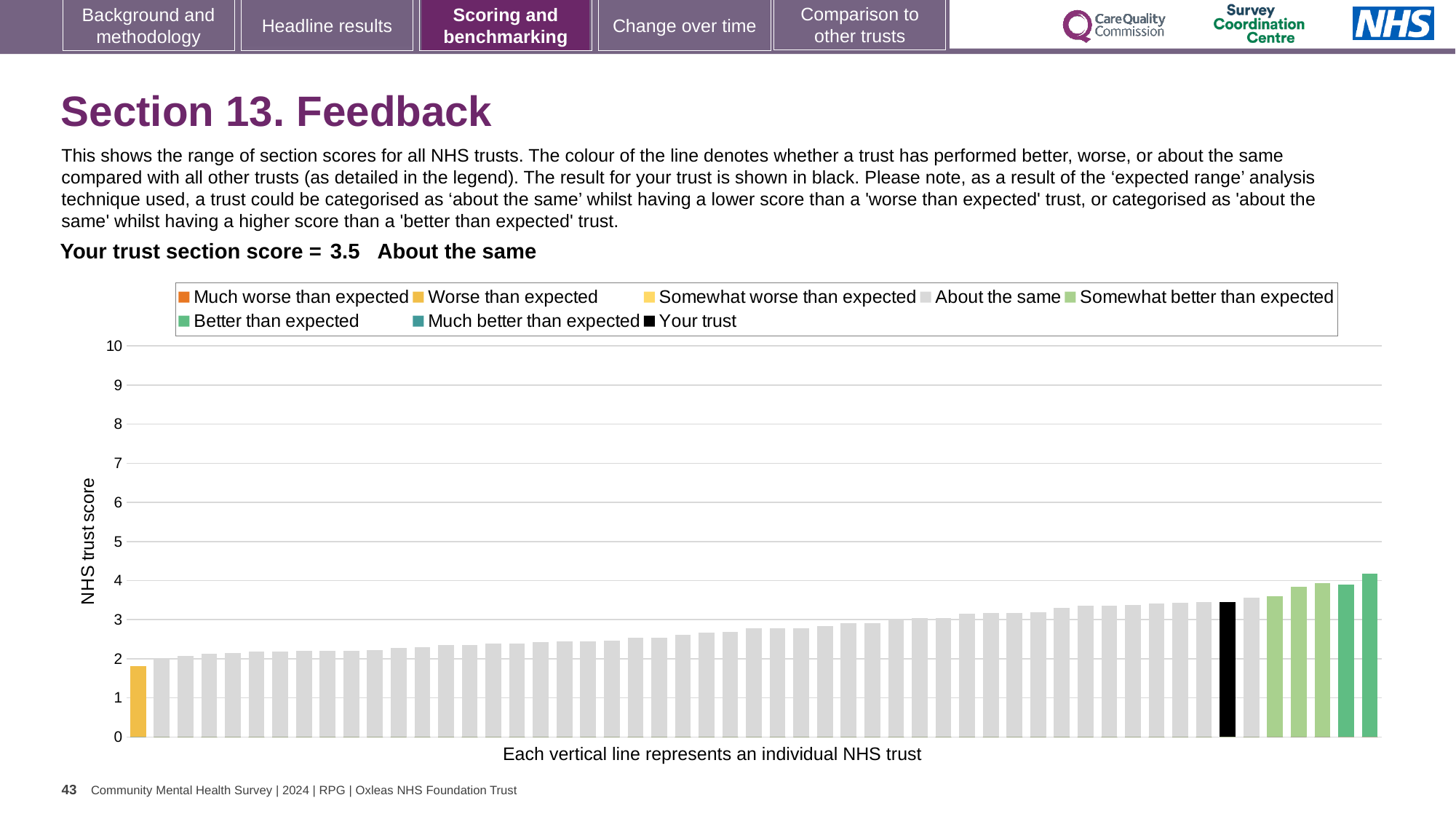
What is the section score for your trust shown on the slide? 3.5 Is the value for your trust (the black bar) greater or less than 4? less Which is larger, the value of the rightmost bar or the value of the black bar for your trust? the rightmost bar How many bars on the chart are coloured yellow (worse than expected)? 1 How many entries does the chart legend list? 8 Is the value of the leftmost (yellow) bar greater or less than 2? less Is the value of the rightmost bar greater or less than 3? greater Do the bar values rise or fall from left to right along the x axis? rise What kind of chart is shown on the slide? bar chart Which category is your trust placed in according to the slide? About the same What is the title of the vertical axis? NHS trust score